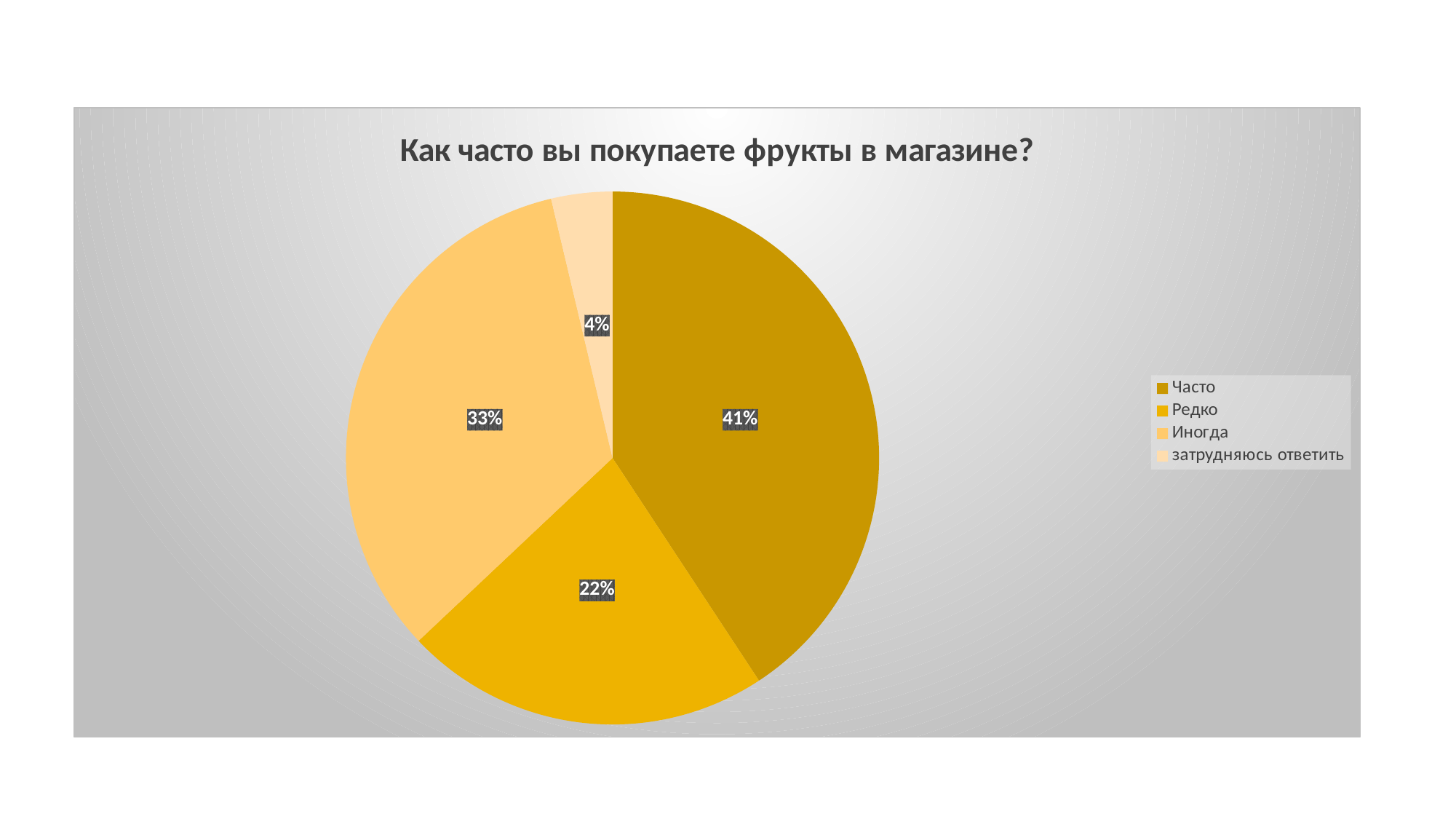
What type of chart is shown on the slide? pie chart What share of the pie does the 'Редко' slice represent? 22% What is the difference in percentage points between the 'Часто' and 'Иногда' slices? 8 What share of the pie does the 'Часто' slice represent? 41% How many categories does the pie chart have? 4 What is the title of the chart? Как часто вы покупаете фрукты в магазине? How many entries does the legend list? 4 What share of the pie does the 'затрудняюсь ответить' slice represent? 4% Which slice is larger, 'Редко' or 'Иногда'? Иногда Which category has the largest slice of the pie? Часто Which category has the smallest slice of the pie? затрудняюсь ответить